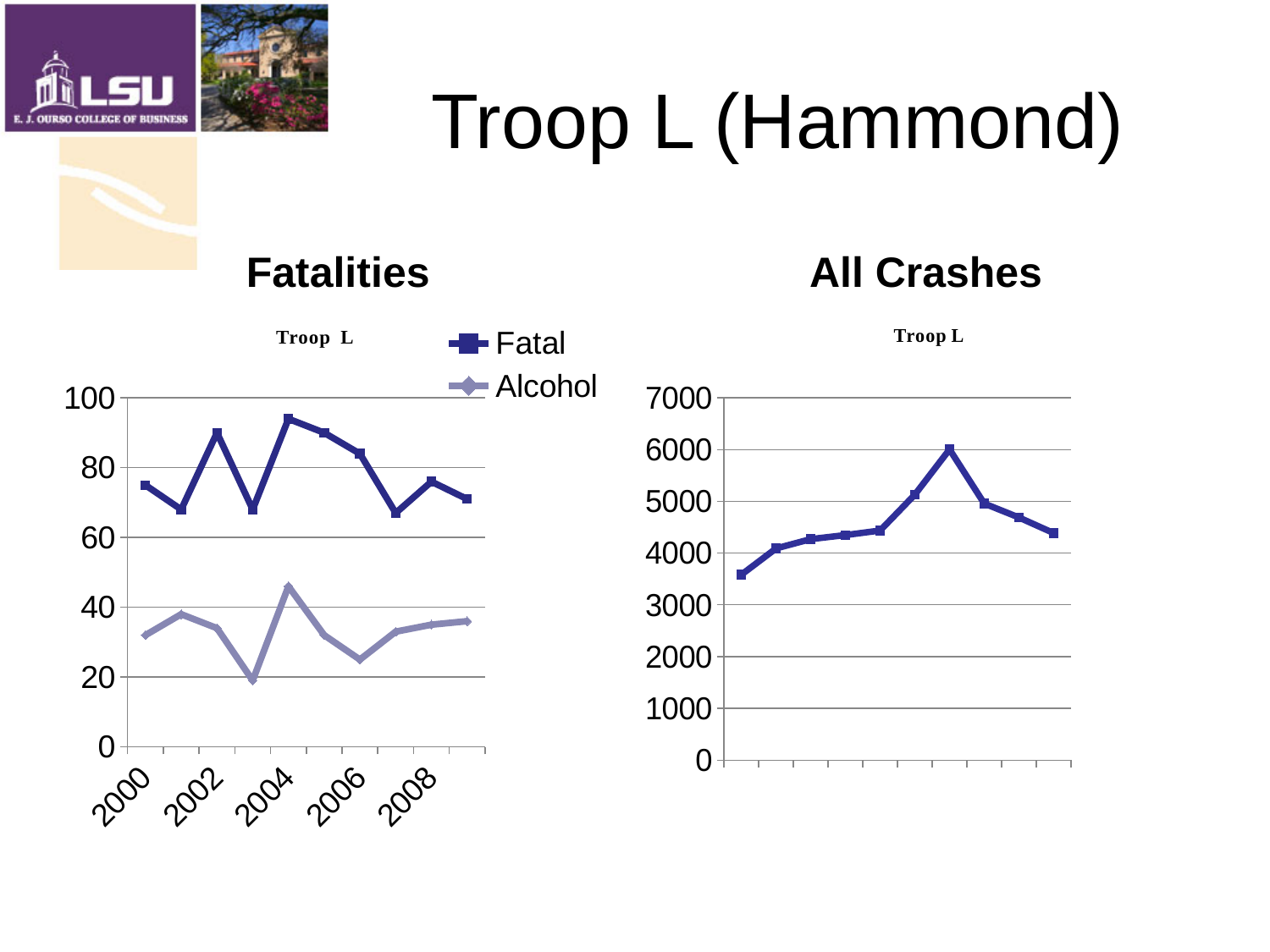
In the Fatalities chart, is the Alcohol value for 2003 greater or less than 40? less In the Fatalities chart, is the Fatal value for 2004 greater or less than 80? greater In the All Crashes chart, is the highest point greater or less than 5000? greater What kind of chart is the Fatalities chart on the left? line chart How many data points are plotted in the All Crashes chart? 10 How many series does the legend of the Fatalities chart list? 2 What are the two series named in the legend of the Fatalities chart? Fatal and Alcohol In the Fatalities chart, which year has the lowest Alcohol value? 2003 What is the title printed above the All Crashes chart on the right? Troop L In the Fatalities chart, which year has the highest Alcohol value? 2004 In the Fatalities chart, which series has the larger value in 2002, Fatal or Alcohol? Fatal